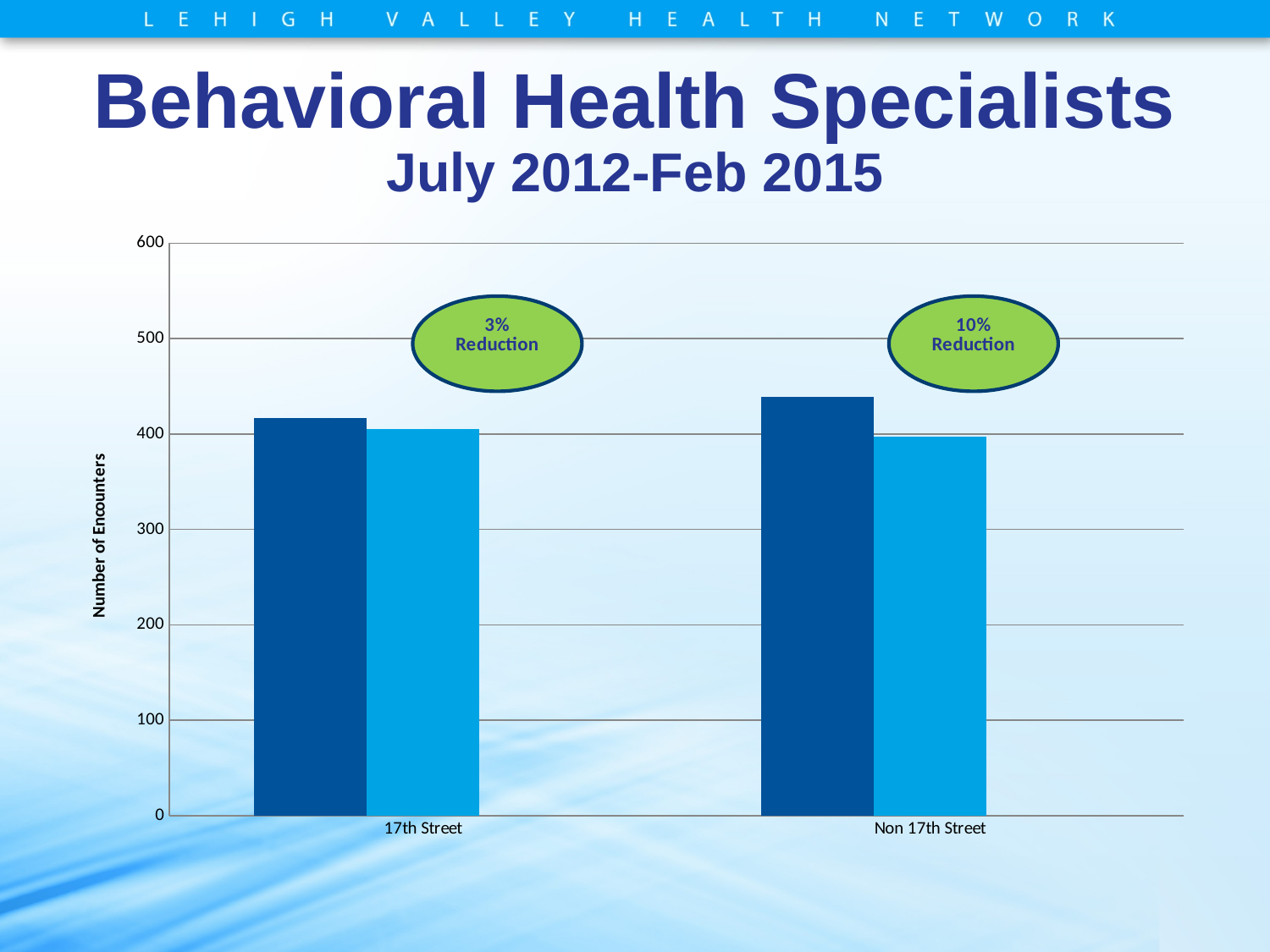
What is the highest value shown on the y axis of the chart? 600 Which category has the tallest bar in the chart? Non 17th Street How many categories are shown on the x axis of the chart? 2 For Non 17th Street, which bar is taller, the dark blue bar or the light blue bar? the dark blue bar Is the value of the dark blue bar for Non 17th Street greater or less than 400? greater Is the value of the dark blue bar for 17th Street greater or less than 400? greater Is the value of the dark blue bar for Non 17th Street greater or less than 500? less What kind of chart is shown on the slide? bar chart What percentage reduction is annotated above the 17th Street bars? 3% Reduction Which category has the larger dark blue bar, 17th Street or Non 17th Street? Non 17th Street What is the label of the y axis of the chart? Number of Encounters